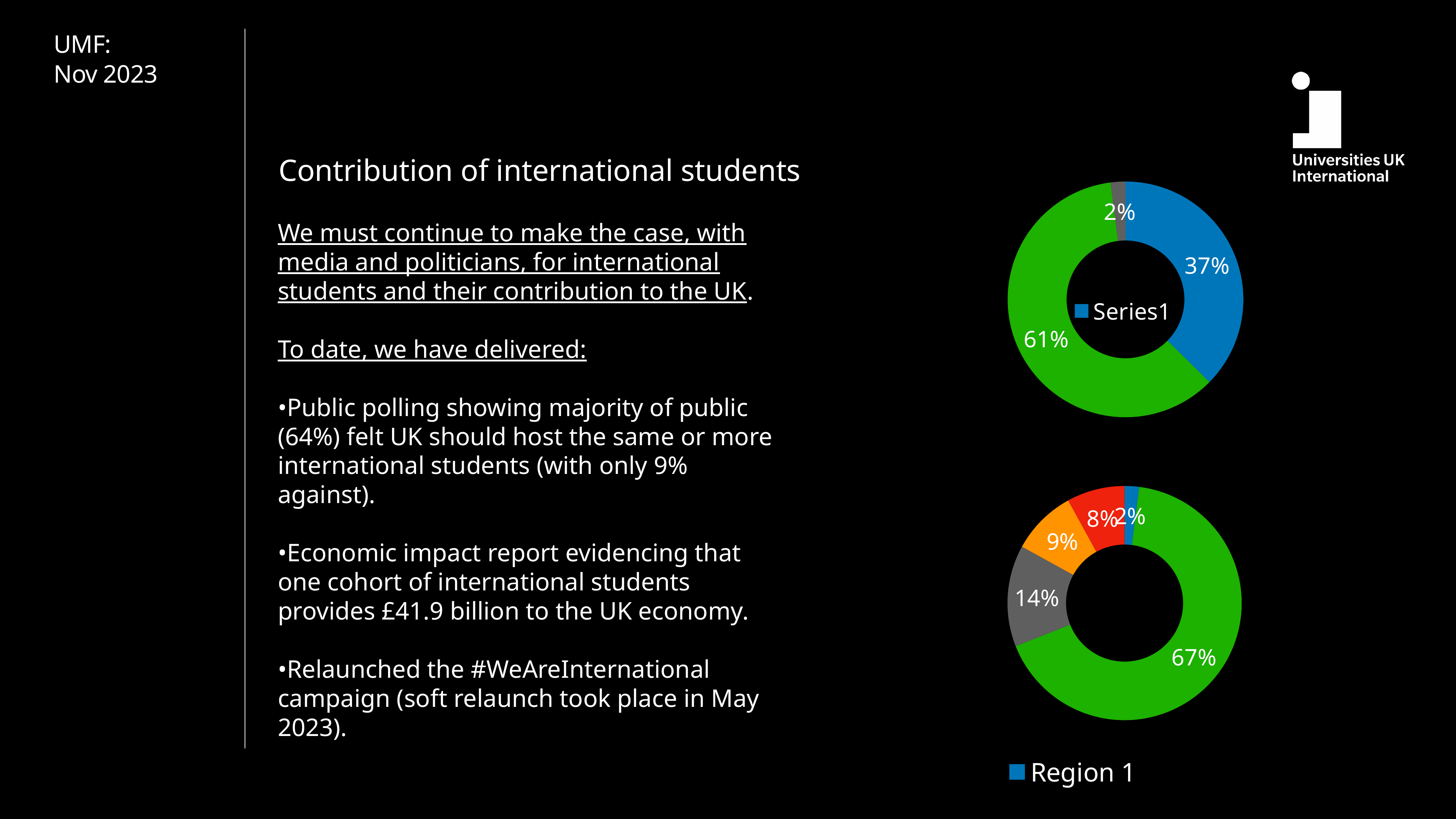
In the top chart, what is the difference between the green slice and the blue slice? 24% In the top chart, what is the smallest slice's value? 2% How many slices does the top chart have? 3 How many slices does the bottom chart have? 5 What kind of chart is the bottom chart on the right of the slide? doughnut chart In the bottom chart, what is the largest slice's value? 67% In the top chart, what percentage is shown for the green slice? 61% What kind of chart is the top chart on the right of the slide? doughnut chart In the top chart, what is the largest slice's value? 61% What legend entry is shown for the bottom chart? Region 1 In the top chart, what percentage is shown for the blue slice? 37% In the bottom chart, what percentage is shown for the grey slice? 14%